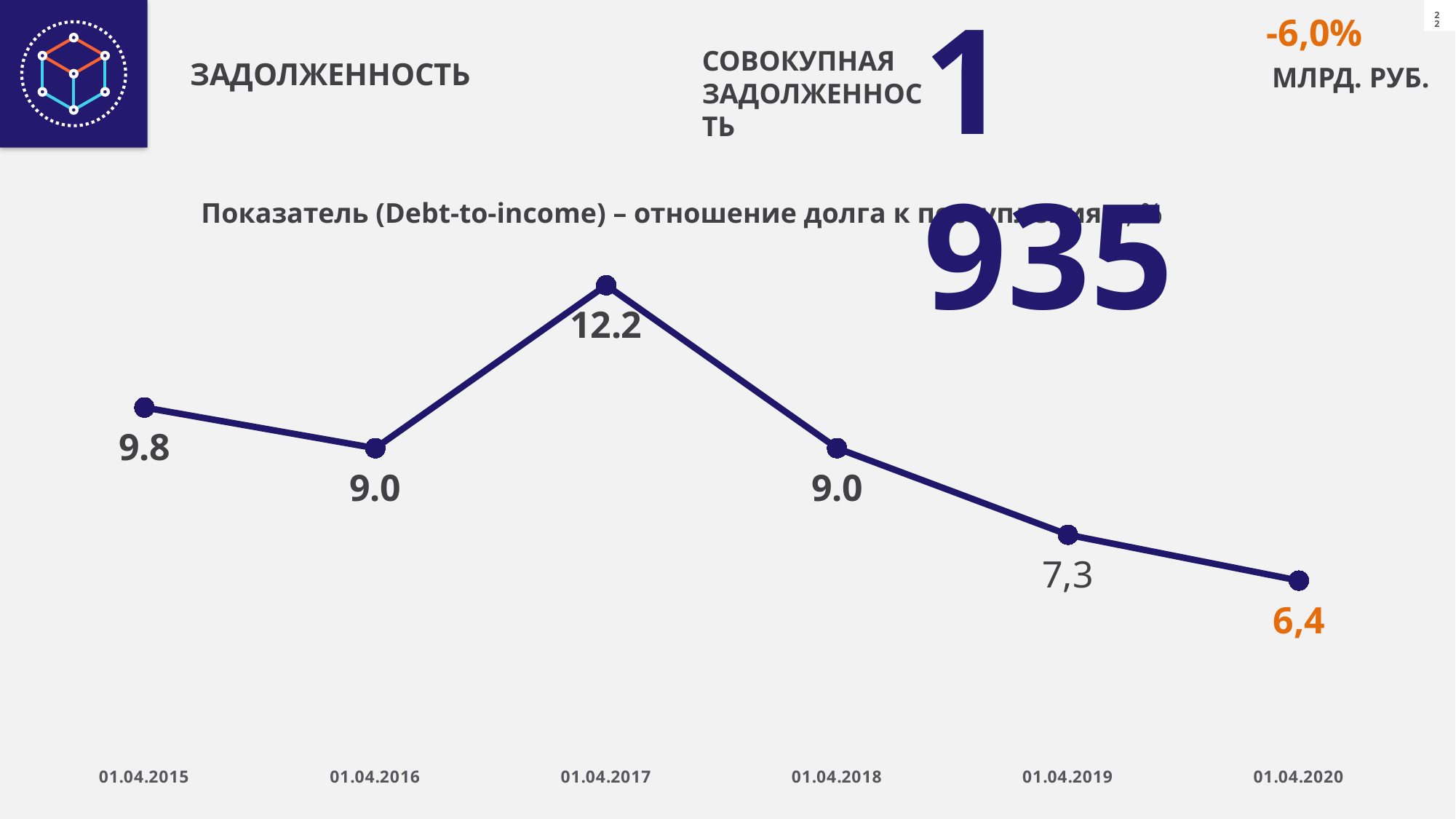
What is the value for 01.04.2019 on the line chart? 7,3 Which date has the highest value on the line chart? 01.04.2017 What is the value for 01.04.2020 on the line chart? 6,4 What is the value for 01.04.2017 on the line chart? 12.2 What is the difference between the values for 01.04.2015 and 01.04.2016? 0.8 What is the value for 01.04.2015 on the line chart? 9.8 What kind of chart is shown on the slide? line chart What is the difference between the values for 01.04.2017 and 01.04.2018? 3.2 Which is larger, the value for 01.04.2015 or the value for 01.04.2016? 01.04.2015 How many data points are plotted on the line chart? 6 Which date has the lowest value on the line chart? 01.04.2020 Between 01.04.2017 and 01.04.2020, do the values on the line chart rise or fall? fall